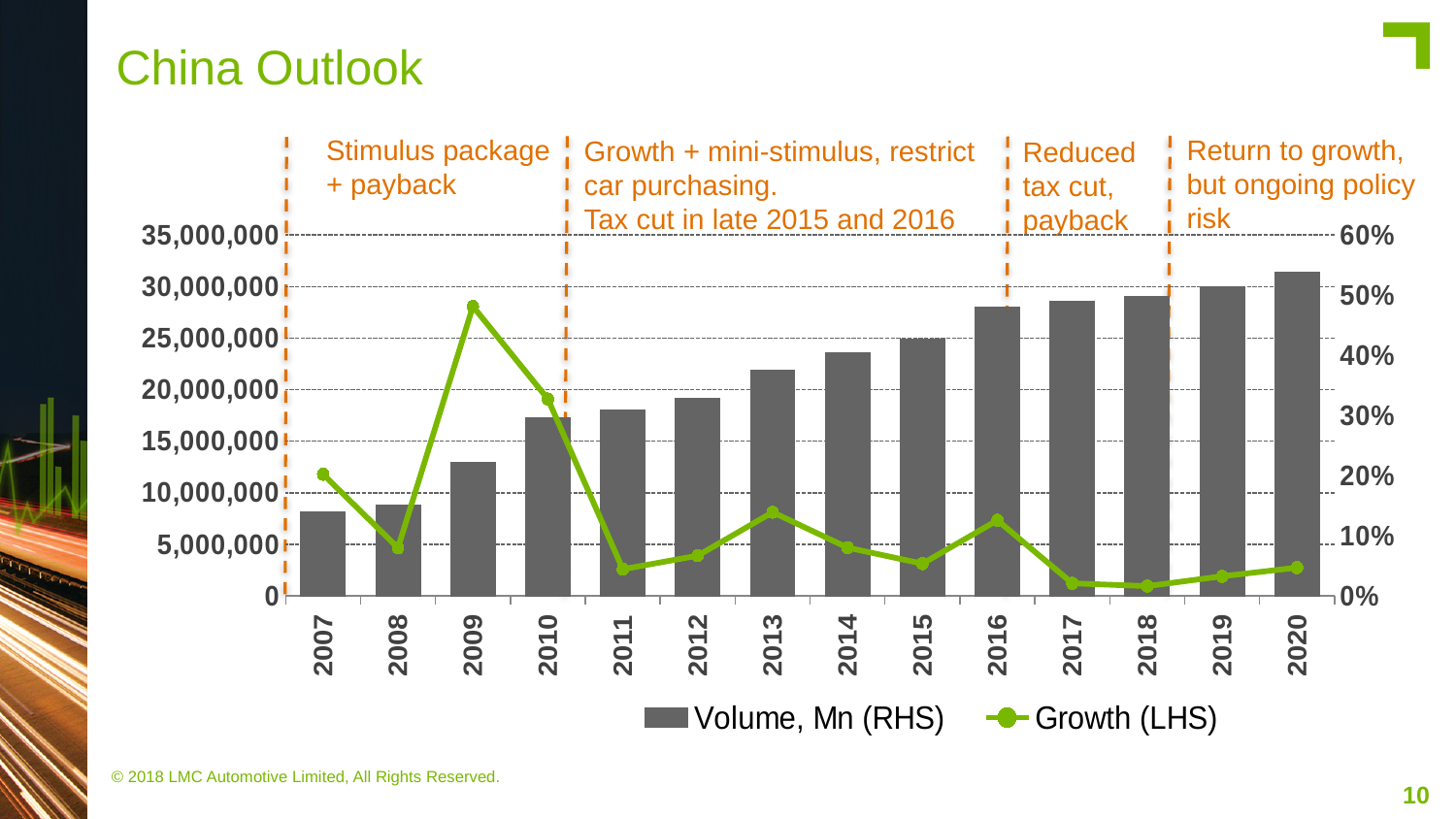
Is the Volume for 2007 greater or less than 10,000,000? less How many series does the chart's legend list? 2 Which year has the lowest Volume bar? 2007 What kind of chart is shown on the slide? A combined bar and line chart How many years are shown on the x axis of the chart? 14 What are the two series named in the chart's legend? Volume, Mn (RHS) and Growth (LHS) Is the Growth value for 2011 greater or less than 10%? less In which year does the Growth line reach its highest point? 2009 Do the Volume bars generally rise or fall from 2007 to 2020? rise Is the Growth value for 2009 greater or less than 40%? greater Which year has the highest Volume bar? 2020 Which year has the larger Growth value, 2009 or 2010? 2009